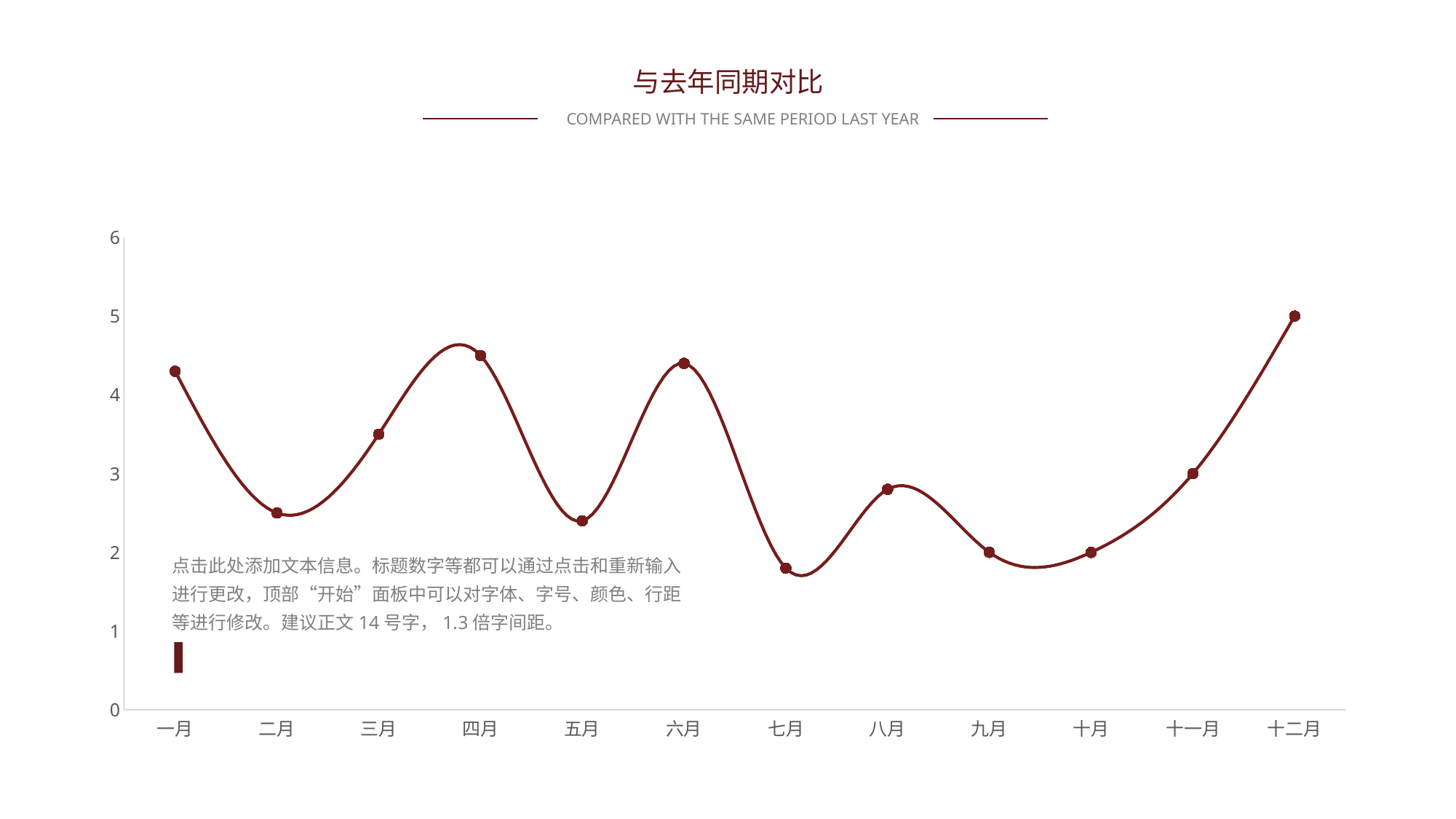
Which is larger, the value for 四月 or the value for 五月? 四月 What is the difference between the values for 十二月 and 十一月? 2 What is the value for 十二月? 5 Is the value for 五月 greater or less than 3? less Do the values rise or fall from 九月 to 十二月? rise What type of chart is shown on the slide? line chart Which month has the highest value? 十二月 Is the value for 一月 greater or less than 4? greater What is the value for 十一月? 3 Which month has the lowest value? 七月 How many months are plotted on the x axis? 12 What is the value for 九月? 2